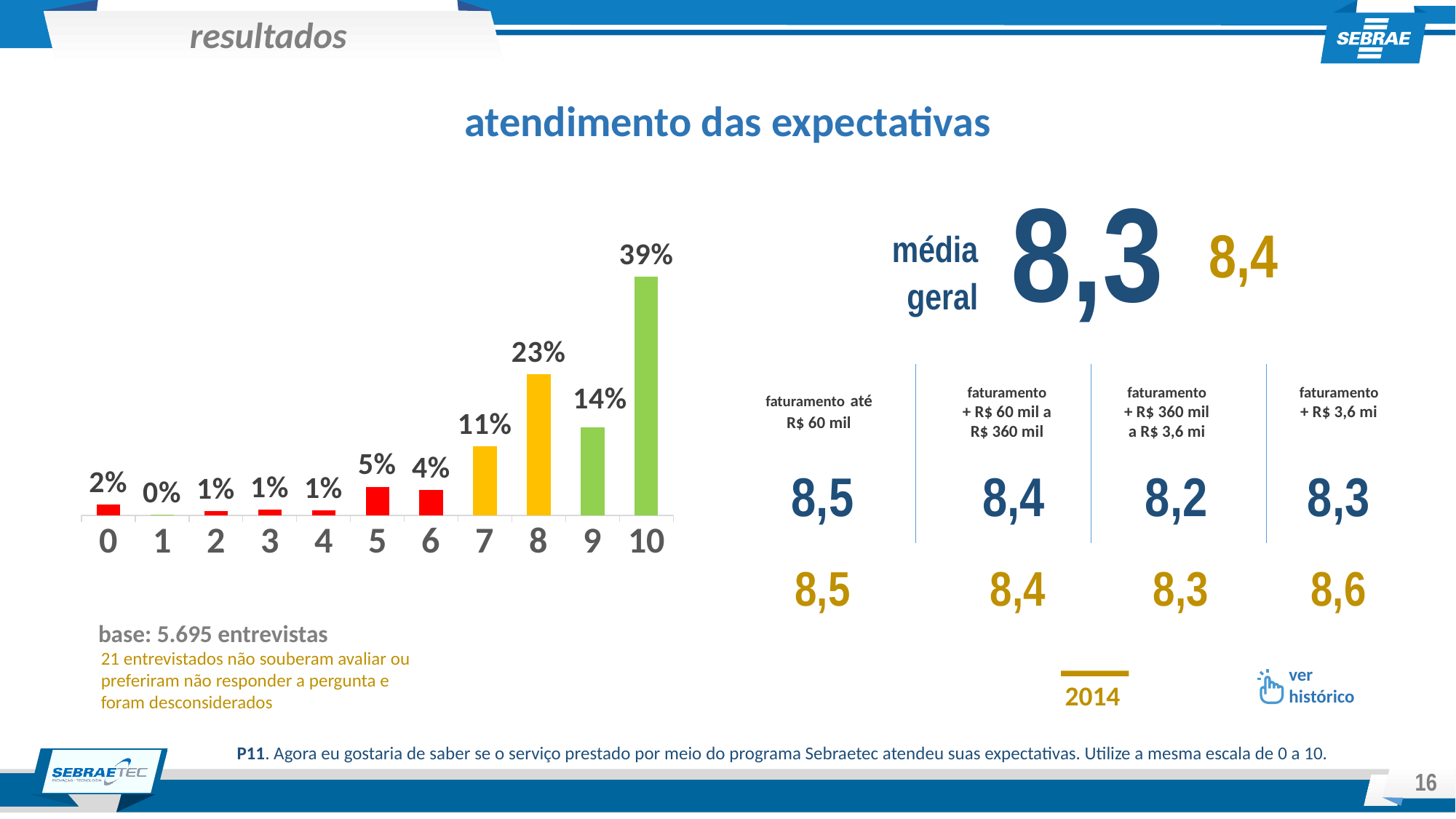
How many score categories are shown on the x axis of the bar chart? 11 Which has a larger percentage in the bar chart, score 9 or score 8? 8 What colour are the bars for scores 9 and 10 in the bar chart? green What percentage of respondents gave a score of 8 in the bar chart? 23% Which score has the lowest percentage in the bar chart? 1 What percentage of respondents gave a score of 10 in the bar chart? 39% What percentage of respondents gave a score of 7 in the bar chart? 11% Which score has the highest percentage in the bar chart? 10 What type of chart is used to show the distribution of scores from 0 to 10? bar chart What is the combined percentage for scores 9 and 10 in the bar chart? 53% What is the difference in percentage points between score 10 and score 8 in the bar chart? 16 What percentage of respondents gave a score of 0 in the bar chart? 2%